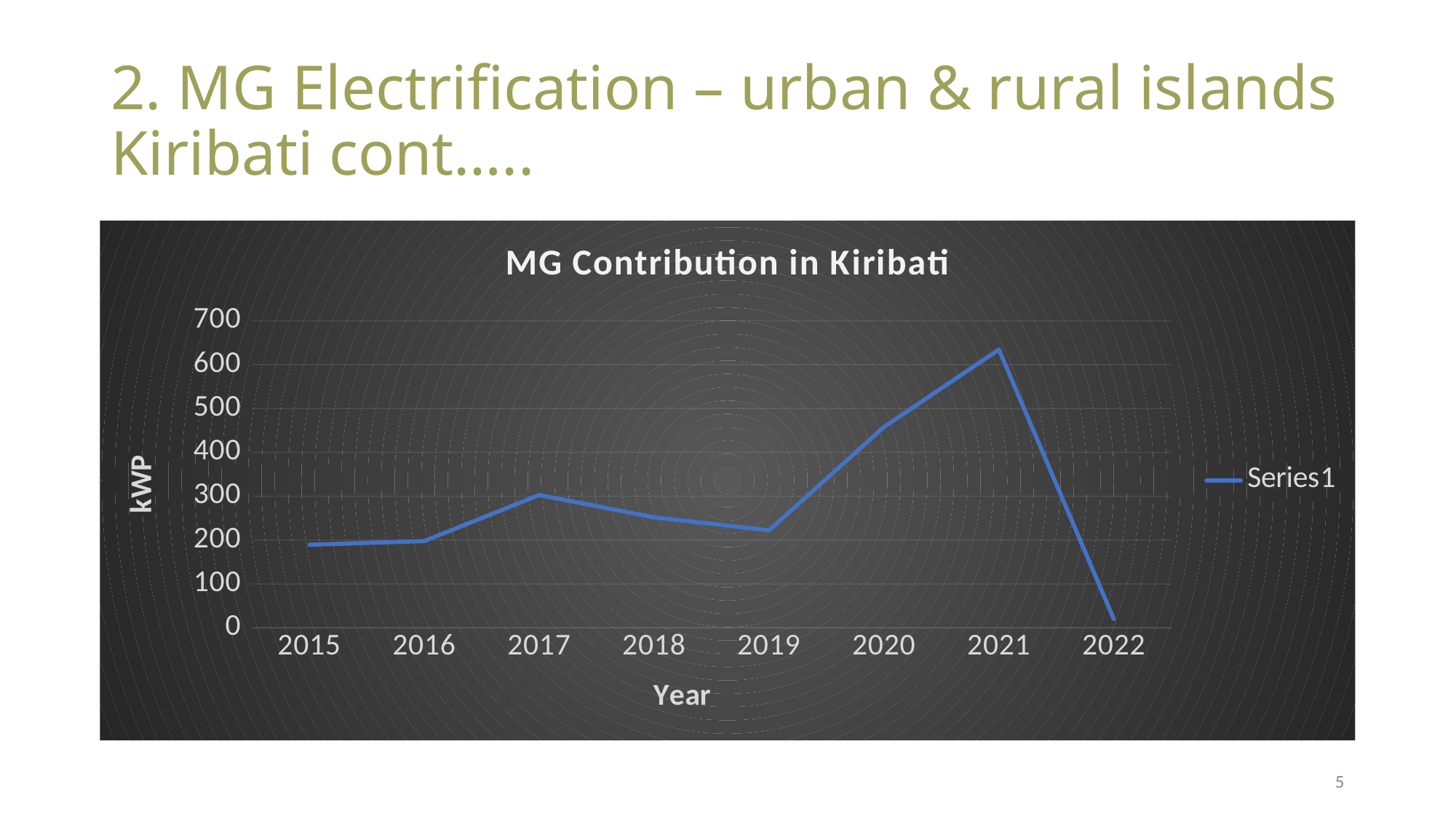
Is the value for 2020 greater or less than 400? greater How many years are plotted along the x axis? 8 Is the value for 2022 greater or less than 100? less Does the value rise or fall from 2019 to 2021? rise Is the value for 2021 greater or less than 600? greater What is the title of the chart? MG Contribution in Kiribati Which year has the highest value? 2021 How many series does the legend list? 1 What kind of chart is shown on the slide? line chart Which year has the larger value, 2019 or 2020? 2020 What is the label on the vertical axis of the chart? kWP Which year has the lowest value? 2022